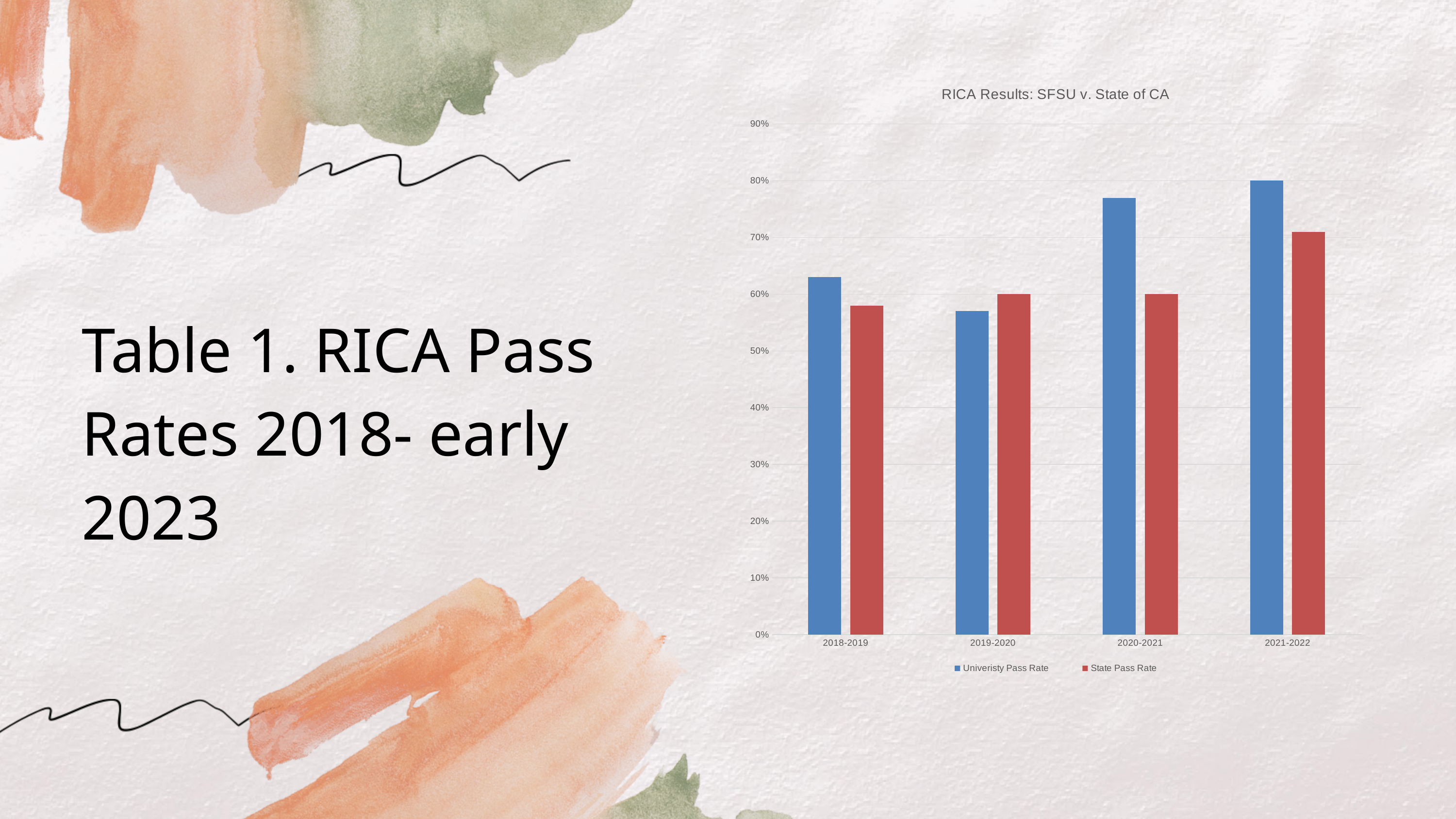
Is the University Pass Rate for 2018-2019 greater or less than 60%? greater What is the title of the chart? RICA Results: SFSU v. State of CA Is the State Pass Rate for 2021-2022 greater or less than 80%? less In which year is the University Pass Rate highest? 2021-2022 How many academic years are shown on the x axis of the chart? 4 In which year is the University Pass Rate lowest? 2019-2020 What colour are the State Pass Rate bars in the chart? red For 2020-2021, which is larger: the University Pass Rate or the State Pass Rate? University Pass Rate For 2019-2020, which is larger: the University Pass Rate or the State Pass Rate? State Pass Rate In which year is the State Pass Rate highest? 2021-2022 How many series does the legend of the chart list? 2 What kind of chart is shown on the slide? bar chart